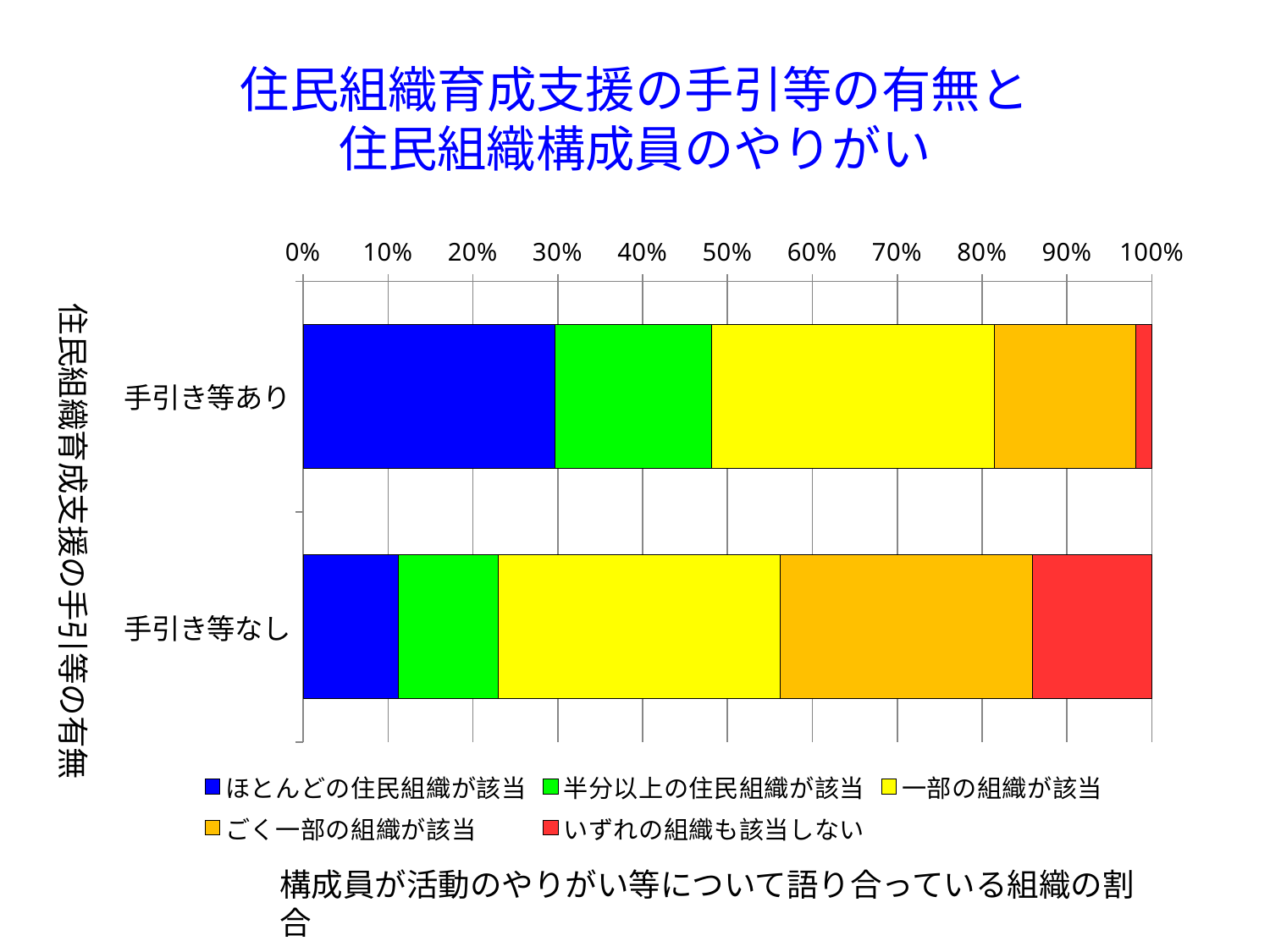
Which legend entry is shown in yellow? 一部の組織が該当 Is the いずれの組織も該当しない share for 手引き等なし greater or less than 10%? greater Which category has the larger ごく一部の組織が該当 (orange) segment, 手引き等あり or 手引き等なし? 手引き等なし What kind of chart is shown on the slide? Stacked bar chart Is the いずれの組織も該当しない share for 手引き等あり greater or less than 10%? less Is the ほとんどの住民組織が該当 share for 手引き等なし greater or less than 20%? less Which category has the larger いずれの組織も該当しない (red) segment, 手引き等あり or 手引き等なし? 手引き等なし How many categories are plotted on the vertical axis? 2 How many series does the legend list? 5 Which category has the larger ほとんどの住民組織が該当 (blue) segment, 手引き等あり or 手引き等なし? 手引き等あり What is the title of the chart? 住民組織育成支援の手引等の有無と住民組織構成員のやりがい